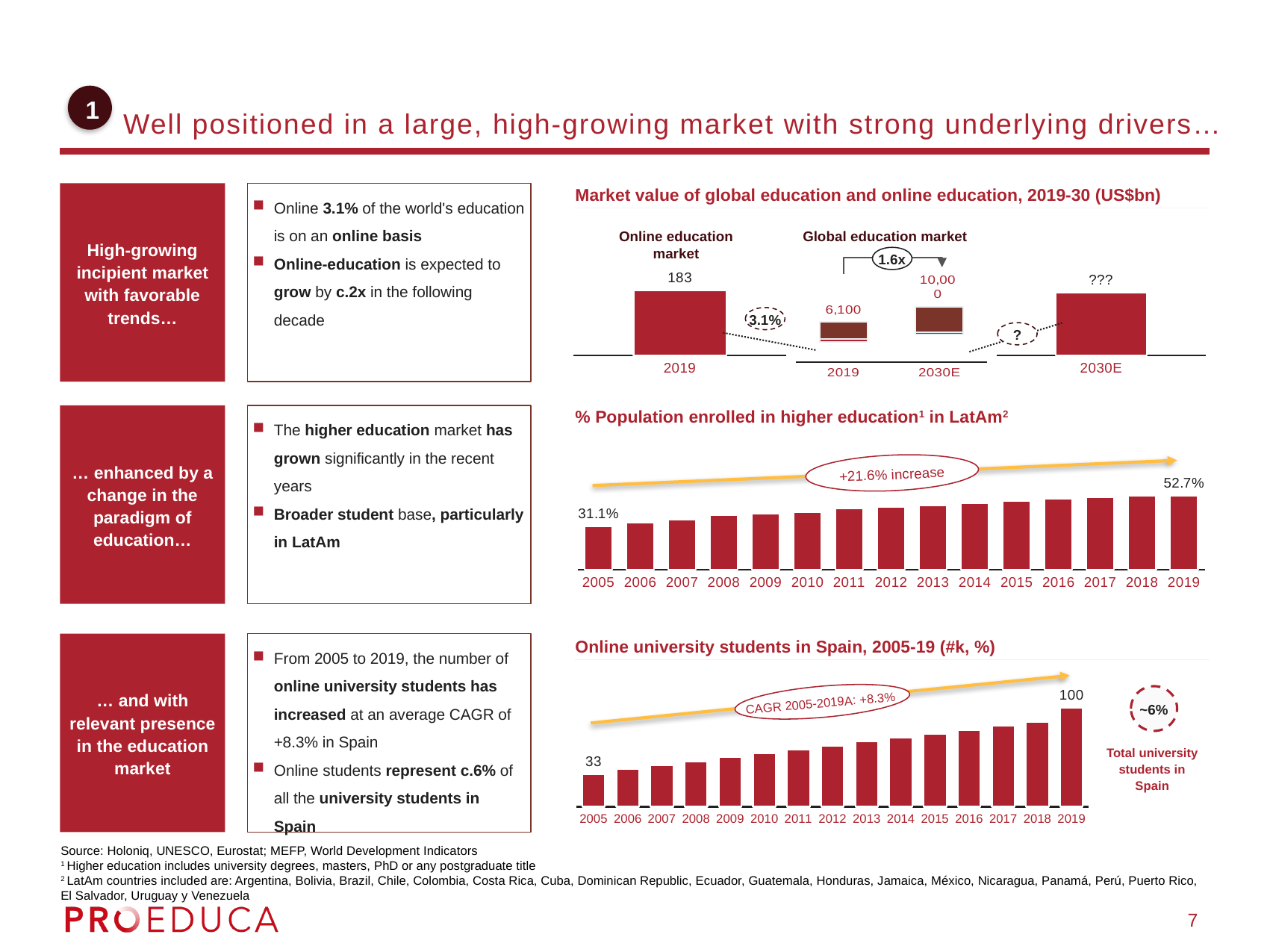
In the 'Market value of global education and online education' chart, by how much is the global education market in 2030E larger than in 2019? 3,900 In the '% Population enrolled in higher education in LatAm' chart, what is the value for 2005? 31.1% In the 'Market value of global education and online education' chart, what is the value of the online education market in 2019? 183 In the '% Population enrolled in higher education in LatAm' chart, what is the value for 2019? 52.7% How many years are plotted in the '% Population enrolled in higher education in LatAm' chart? 15 In the 'Online university students in Spain' chart, what is the difference between the 2019 and 2005 values? 67 In the '% Population enrolled in higher education in LatAm' chart, do the values rise or fall from 2005 to 2019? rise In the 'Market value of global education and online education' chart, what is the value of the global education market in 2019? 6,100 What kind of chart is the 'Online university students in Spain, 2005-19' chart? bar chart In the 'Online university students in Spain' chart, what is the value for 2005? 33 In the 'Market value of global education and online education' chart, what is the value of the global education market in 2030E? 10,000 In the '% Population enrolled in higher education in LatAm' chart, what is the difference between the 2019 and 2005 values? 21.6%